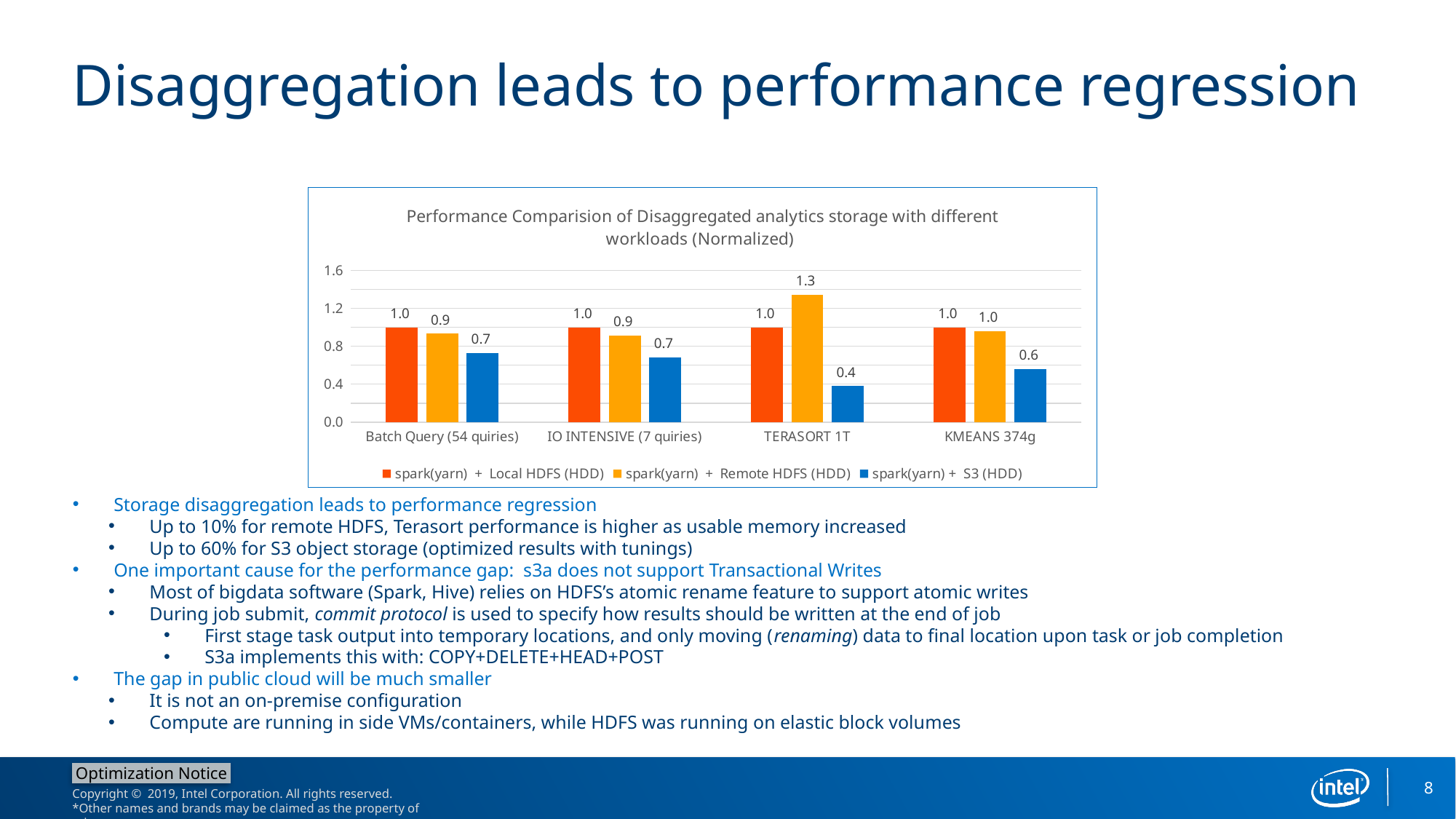
For TERASORT 1T, which is larger: spark(yarn) + Local HDFS (HDD) or spark(yarn) + Remote HDFS (HDD)? spark(yarn) + Remote HDFS (HDD) What is the title of the chart? Performance Comparision of Disaggregated analytics storage with different workloads (Normalized) What is the value for spark(yarn) + S3 (HDD) for KMEANS 374g? 0.6 What is the value for spark(yarn) + Remote HDFS (HDD) for TERASORT 1T? 1.3 How many workload categories are shown on the x axis? 4 How many series does the legend list? 3 What is the value for spark(yarn) + Remote HDFS (HDD) for Batch Query (54 quiries)? 0.9 For which workload is the spark(yarn) + Remote HDFS (HDD) value highest? TERASORT 1T What is the value for spark(yarn) + S3 (HDD) for TERASORT 1T? 0.4 For which workload is the spark(yarn) + S3 (HDD) value lowest? TERASORT 1T What is the difference between the spark(yarn) + Remote HDFS (HDD) and spark(yarn) + S3 (HDD) values for TERASORT 1T? 0.9 What type of chart is shown on the slide? bar chart